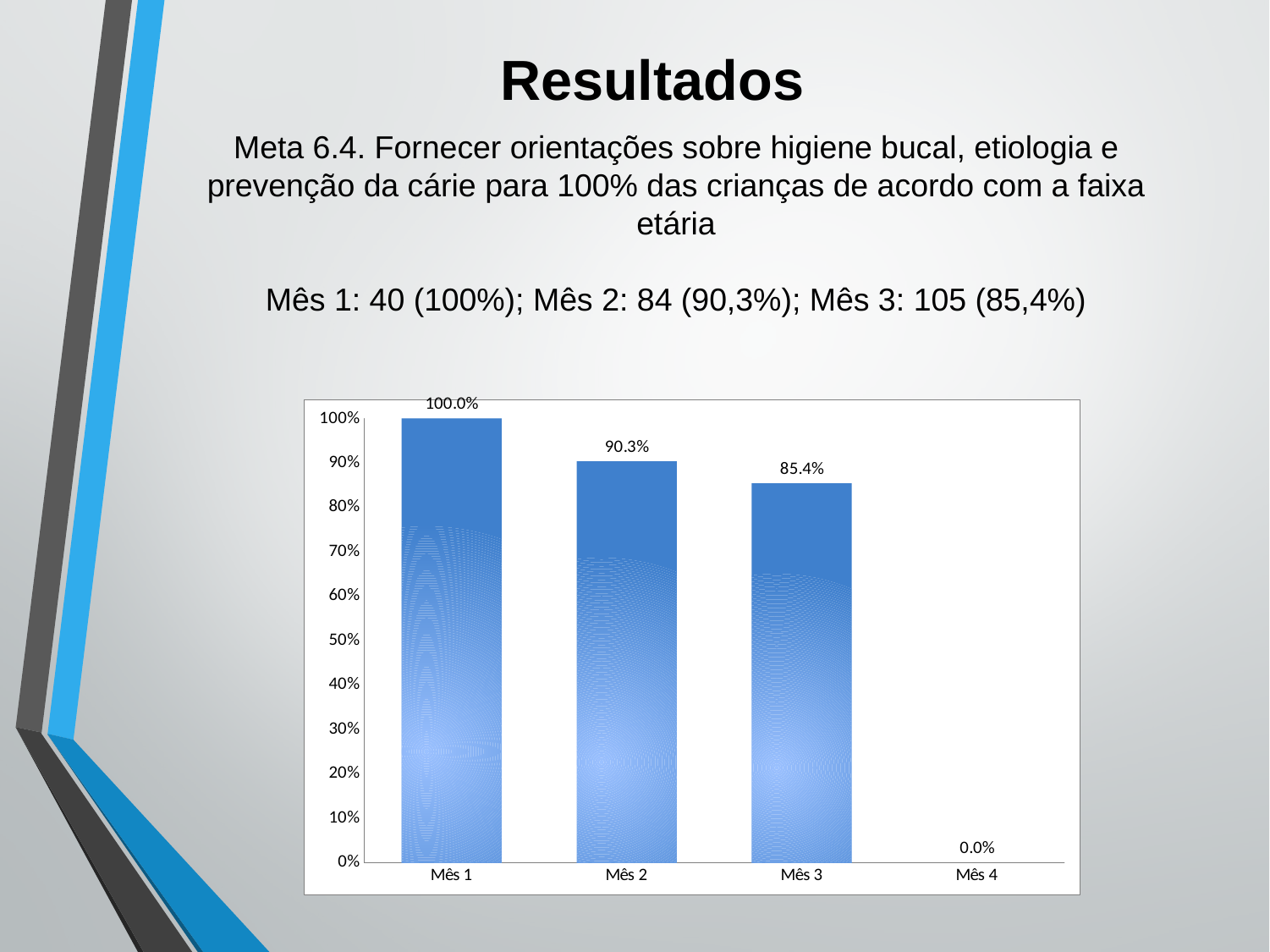
Is the value for Mês 3 greater or less than 80%? greater What is the value for Mês 3? 85.4% How many categories are shown on the x axis? 4 Which category has the highest value? Mês 1 What is the difference between the values for Mês 2 and Mês 3? 4.9% Which is larger, the value for Mês 2 or the value for Mês 3? Mês 2 What is the value for Mês 1? 100.0% What is the value for Mês 2? 90.3% Which category has the lowest value? Mês 4 What kind of chart is shown on the slide? bar chart What is the value for Mês 4? 0.0% Do the values rise or fall from Mês 1 to Mês 4? fall